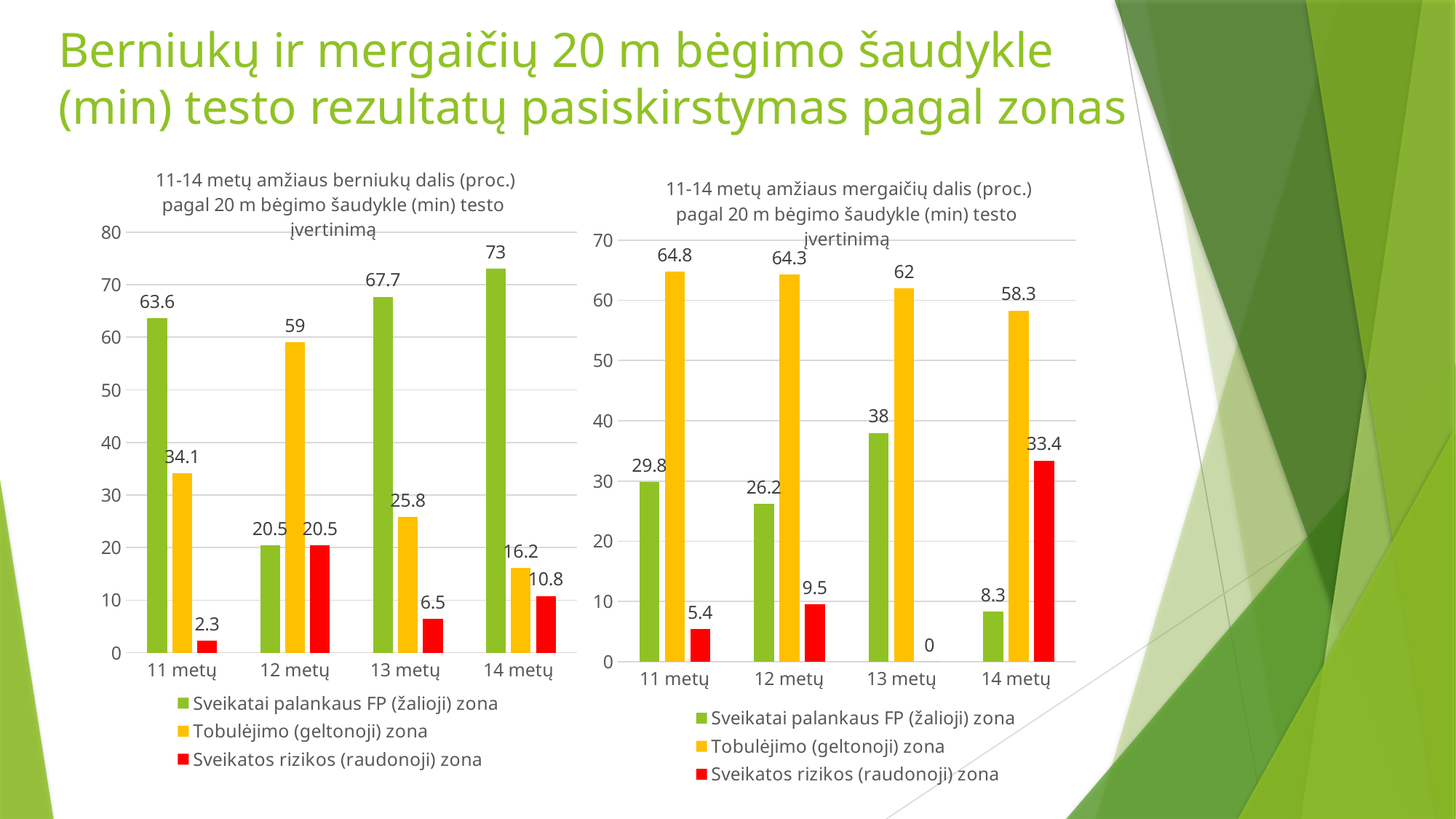
In the left chart (berniukų), which age group has the lowest value for the Sveikatai palankaus FP (žalioji) zona series? 12 metų How many series does the legend of the right chart (mergaičių) list? 3 In the right chart (mergaičių), which age group has the highest value for the Sveikatos rizikos (raudonoji) zona series? 14 metų In the right chart (mergaičių), what is the difference between the Tobulėjimo (geltonoji) zona value and the Sveikatai palankaus FP (žalioji) zona value for 13 metų? 24 In the right chart (mergaičių), what is the value of the Tobulėjimo (geltonoji) zona series for 11 metų? 64.8 In the left chart (berniukų), which is larger for 12 metų: the Sveikatai palankaus FP (žalioji) zona value or the Tobulėjimo (geltonoji) zona value? Tobulėjimo (geltonoji) zona How many age groups are shown on the x axis of the left chart (berniukų)? 4 What kind of chart is the left chart (berniukų)? bar chart In the right chart (mergaičių), what is the value of the Sveikatos rizikos (raudonoji) zona series for 13 metų? 0 In the right chart (mergaičių), is the Sveikatai palankaus FP (žalioji) zona value for 14 metų greater or less than 10? less In the left chart (berniukų), what is the value of the Sveikatai palankaus FP (žalioji) zona series for 14 metų? 73 In the left chart (berniukų), what is the value of the Sveikatos rizikos (raudonoji) zona series for 11 metų? 2.3